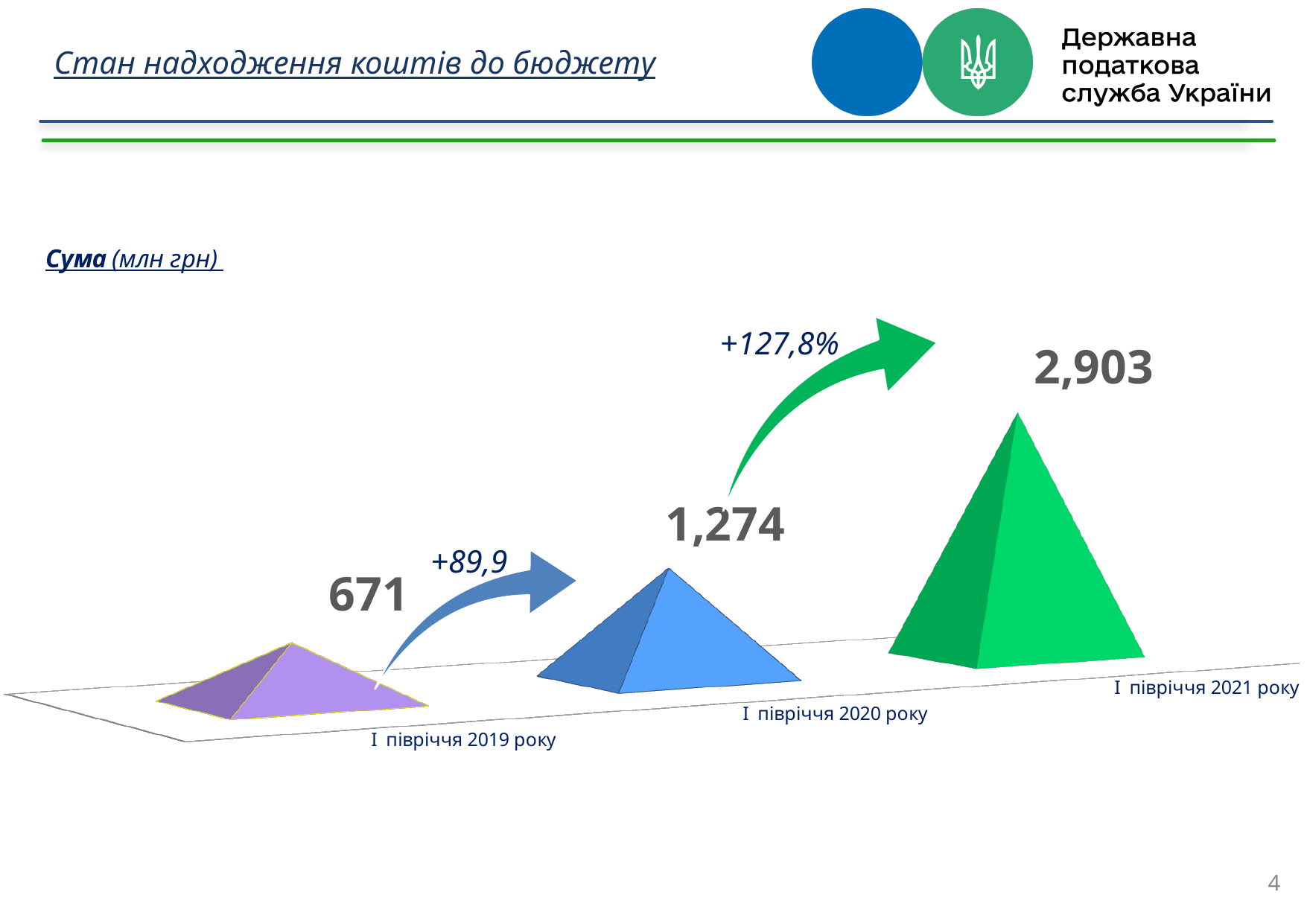
What unit is stated for the values in the chart? млн грн What percentage growth is shown by the arrow between I півріччя 2020 року and I півріччя 2021 року? +127,8% What is the value for I півріччя 2021 року? 2,903 What is the difference between the values for I півріччя 2021 року and I півріччя 2020 року? 1,629 Which is larger, the value for I півріччя 2020 року or I півріччя 2021 року? I півріччя 2021 року How many periods are shown in the chart? 3 What is the value for I півріччя 2019 року? 671 What is the difference between the values for I півріччя 2020 року and I півріччя 2019 року? 603 Which period has the highest value? I півріччя 2021 року Which period has the lowest value? I півріччя 2019 року Do the values rise or fall from I півріччя 2019 року to I півріччя 2021 року? rise What is the value for I півріччя 2020 року? 1,274